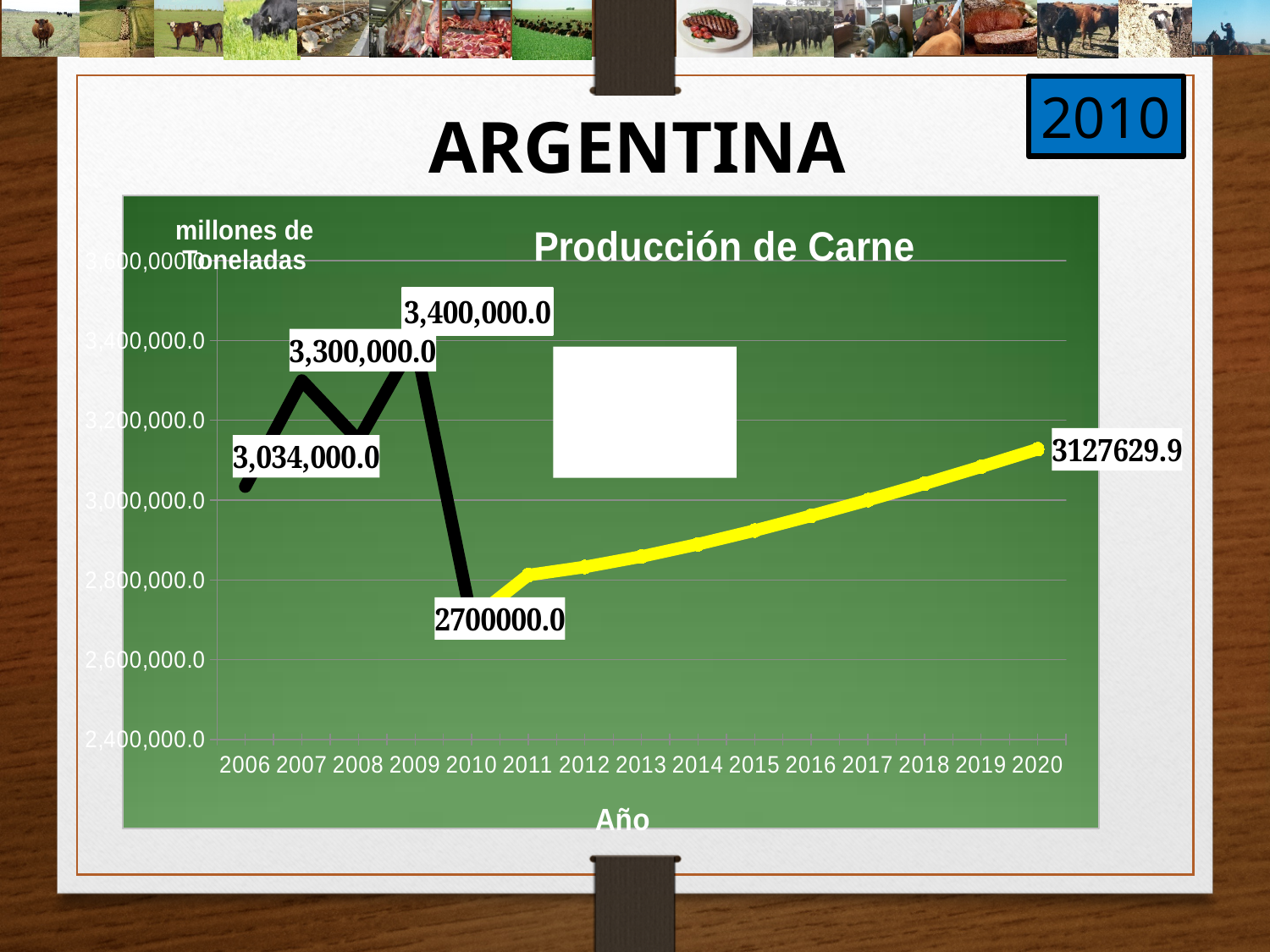
What is the value for 2010? 2700000.0 What is the value for 2006? 3,034,000.0 What is the value for 2009? 3,400,000.0 Which year has the lowest value? 2010 Which is larger, the value for 2007 or the value for 2020? 2007 What is the value for 2007? 3,300,000.0 What is the value for 2020? 3127629.9 Which year has the highest value? 2009 What is the title of the chart? Producción de Carne What is the difference between the values for 2009 and 2010? 700,000.0 Is the value for 2015 greater or less than 3,000,000.0? less What kind of chart is shown on the slide? line chart